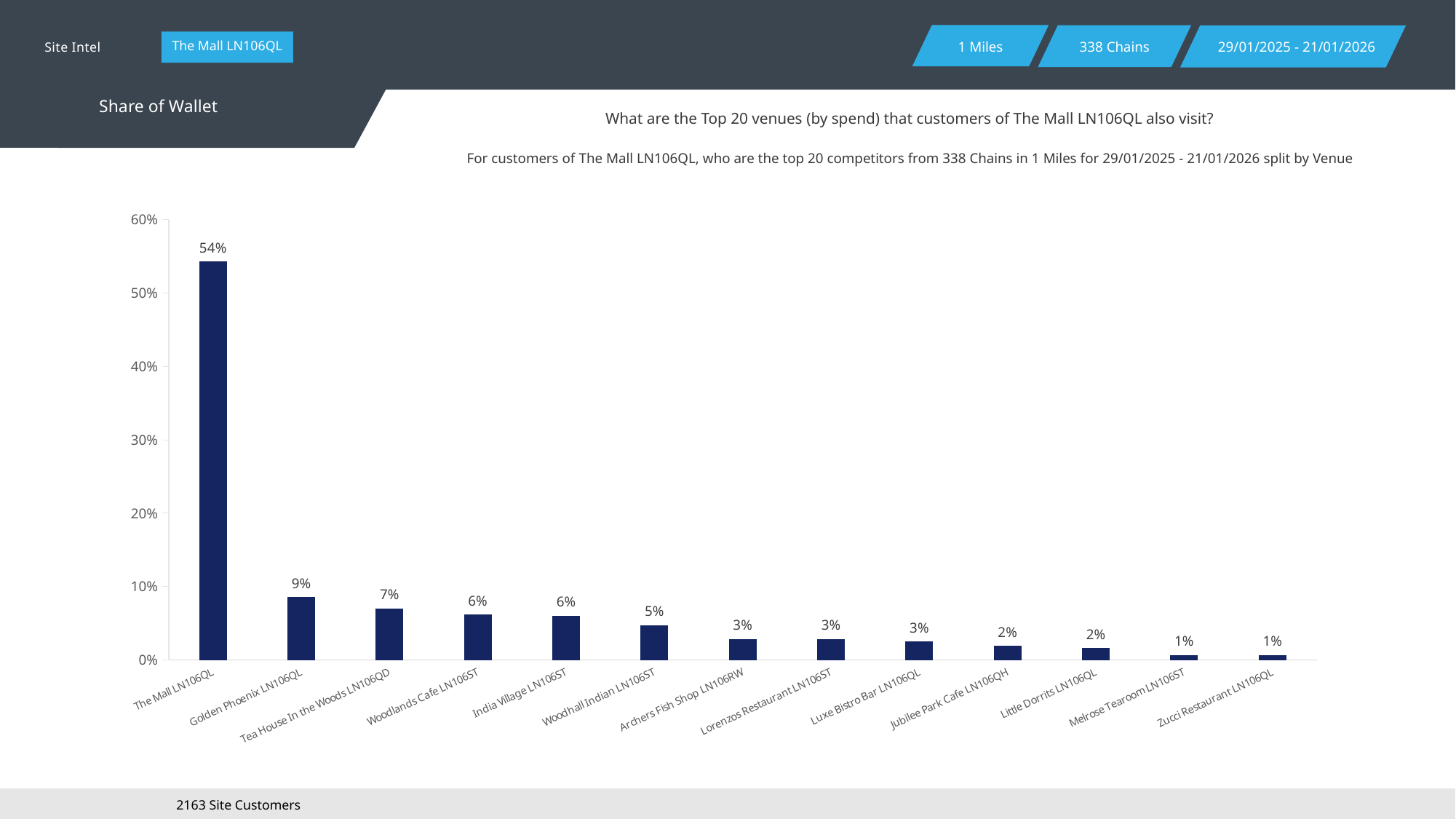
What is the value for The Mall LN106QL? 54% Is the value for The Mall LN106QL greater or less than 50%? greater What is the value for Jubilee Park Cafe LN106QH? 2% What is the value for Woodhall Indian LN106ST? 5% Which is larger, the value for Tea House In the Woods LN106QD or the value for Woodhall Indian LN106ST? Tea House In the Woods LN106QD Do the values rise or fall from left to right along the x axis? Fall Which venue has the highest value? The Mall LN106QL What is the difference between the values for The Mall LN106QL and Golden Phoenix LN106QL? 45% What kind of chart is shown on the slide? Bar chart How many venues are shown on the chart? 13 What is the value for Tea House In the Woods LN106QD? 7% What is the value for Golden Phoenix LN106QL? 9%